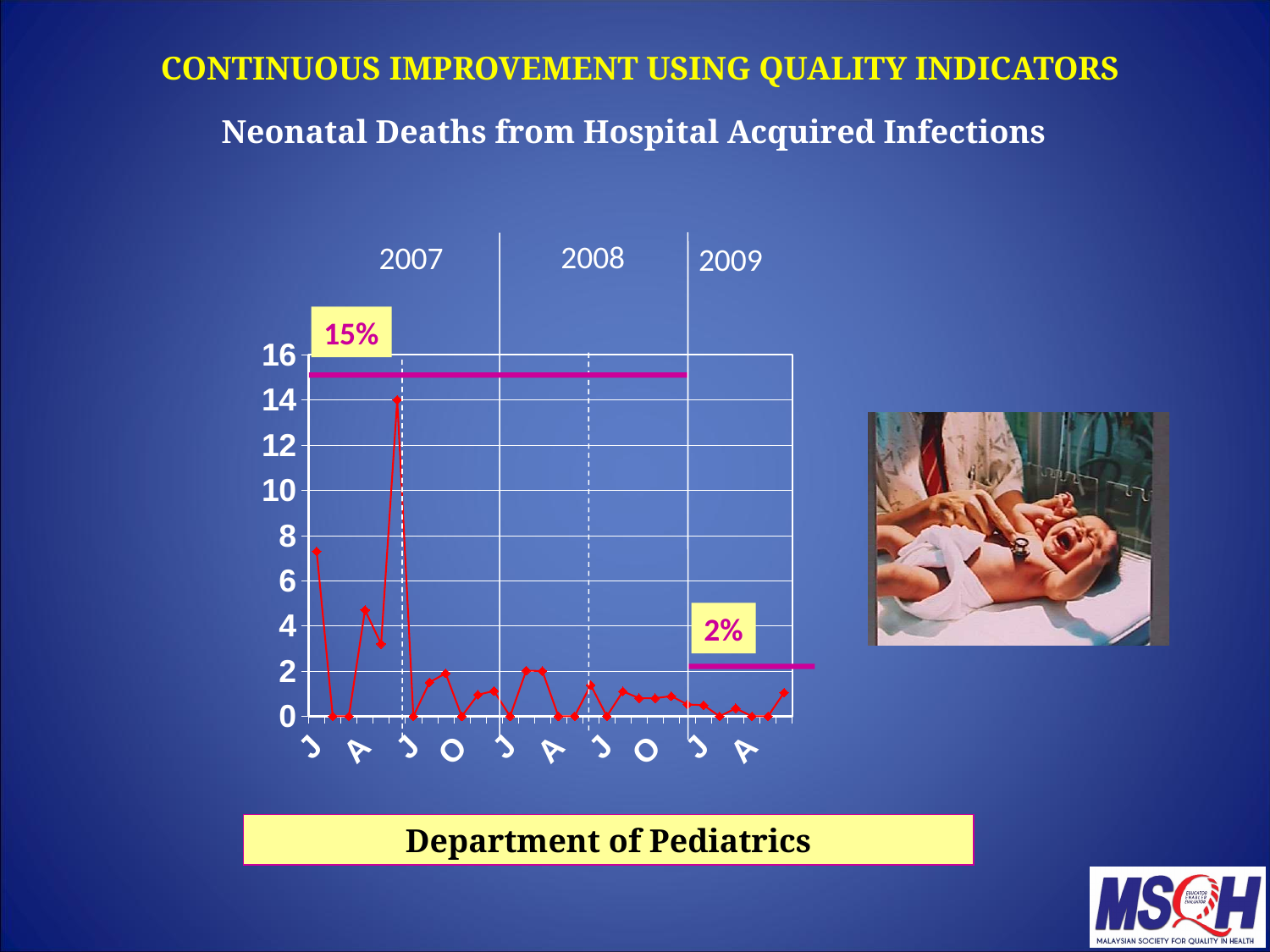
Which reference line is higher on the chart, the 15% line or the 2% line? 15% How many years are labelled along the top of the chart? 3 What is the title of the chart on the slide? Neonatal Deaths from Hospital Acquired Infections Is the highest point on the line greater or less than 12? greater Is the value for the first point (J 2007) greater or less than 6? greater Which department is named in the box below the chart? Department of Pediatrics What are the two percentage labels shown next to the horizontal reference lines on the chart? 15% and 2% In which year does the highest point on the line occur? 2007 What kind of chart is shown on the slide? line chart Are all the values plotted in 2008 greater or less than 4? less What is the highest value shown on the y axis? 16 Do the values on the line generally rise or fall from 2007 to 2009? fall